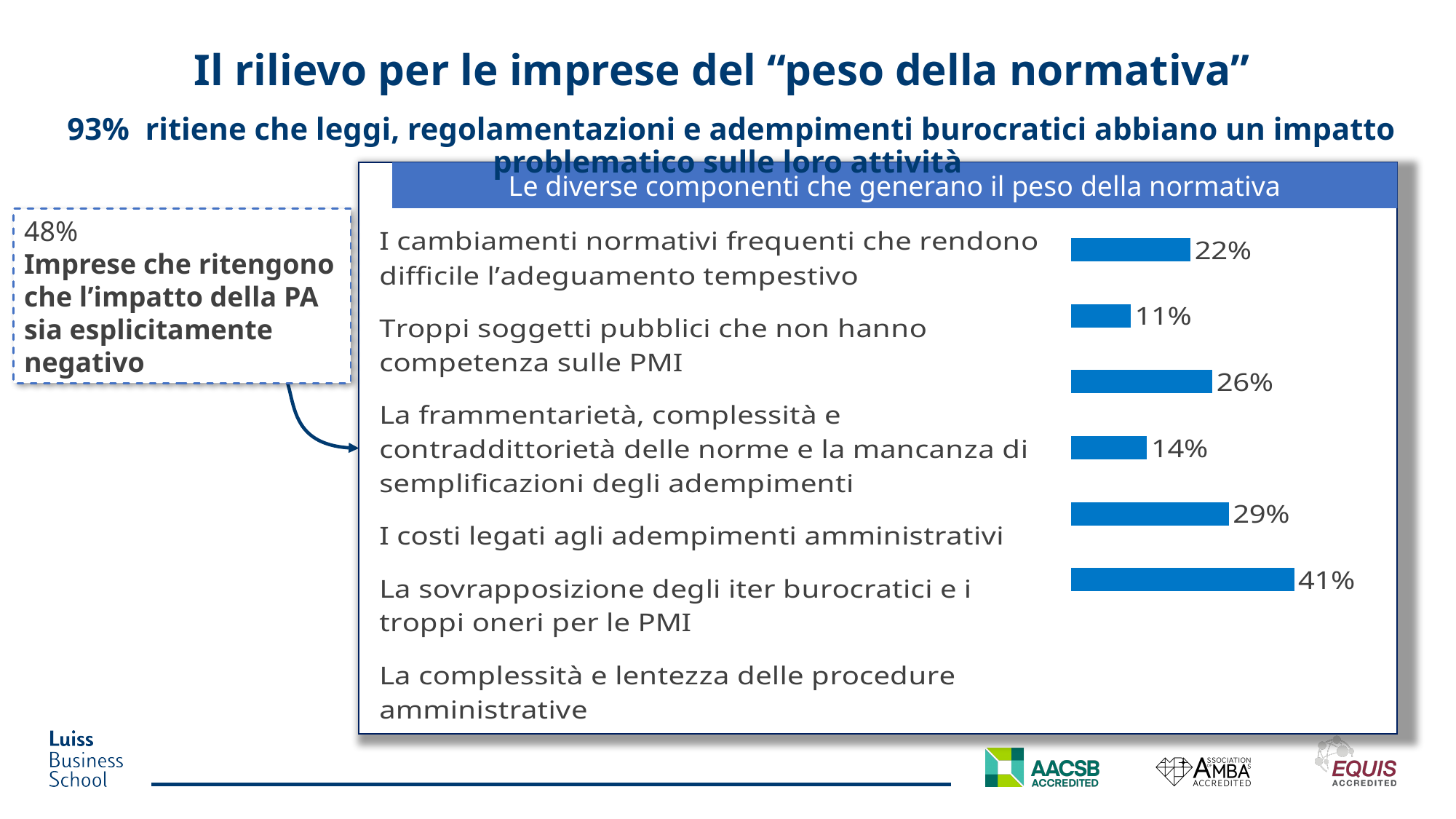
What is the value of the bottom bar in the chart? 41% How many bars does the chart contain? 6 What is the title of the chart? Le diverse componenti che generano il peso della normativa What colour are the bars in the chart? blue What is the lowest value shown in the chart? 11% What is the value of the topmost bar in the chart? 22% What is the difference between the largest bar (41%) and the second largest bar (29%)? 12 percentage points What is the value for 'I cambiamenti normativi frequenti che rendono difficile l'adeguamento tempestivo'? 22% What is the value of the second bar from the top? 11% What is the highest value shown in the chart? 41% What kind of chart is shown on the slide? bar chart Which is larger, the third bar from the top (26%) or the topmost bar (22%)? 26%